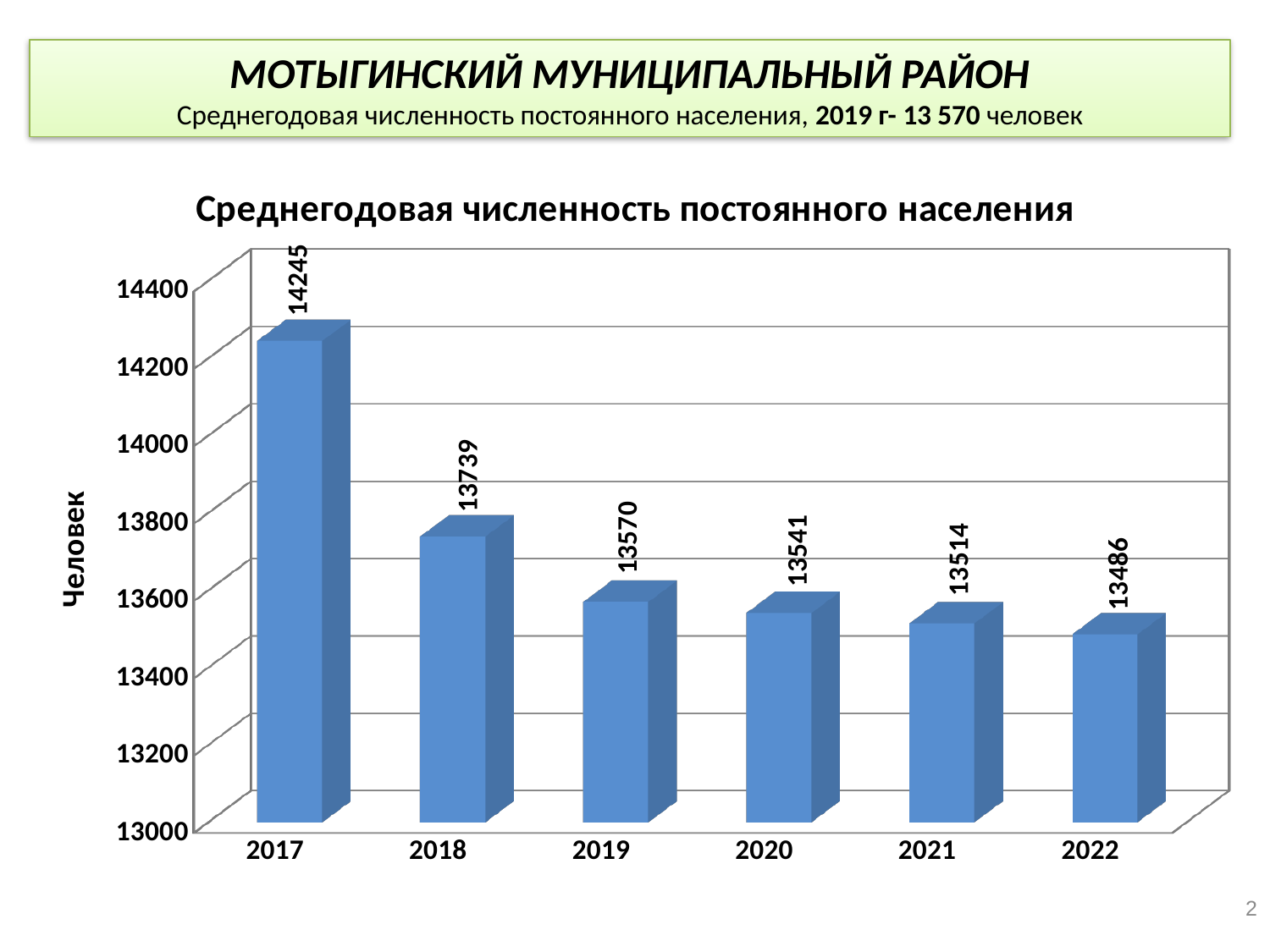
Is the value for 2021 greater or less than 13600? less How many years are shown on the x axis? 6 Which is larger, the value for 2018 or the value for 2020? 2018 What is the value for 2019? 13570 What is the difference between the values for 2017 and 2018? 506 Do the values rise or fall from 2017 to 2022? fall Which year has the lowest value? 2022 What kind of chart is shown on the slide? bar chart What is the difference between the values for 2019 and 2022? 84 What is the value for 2022? 13486 What is the value for 2017? 14245 Which year has the highest value? 2017